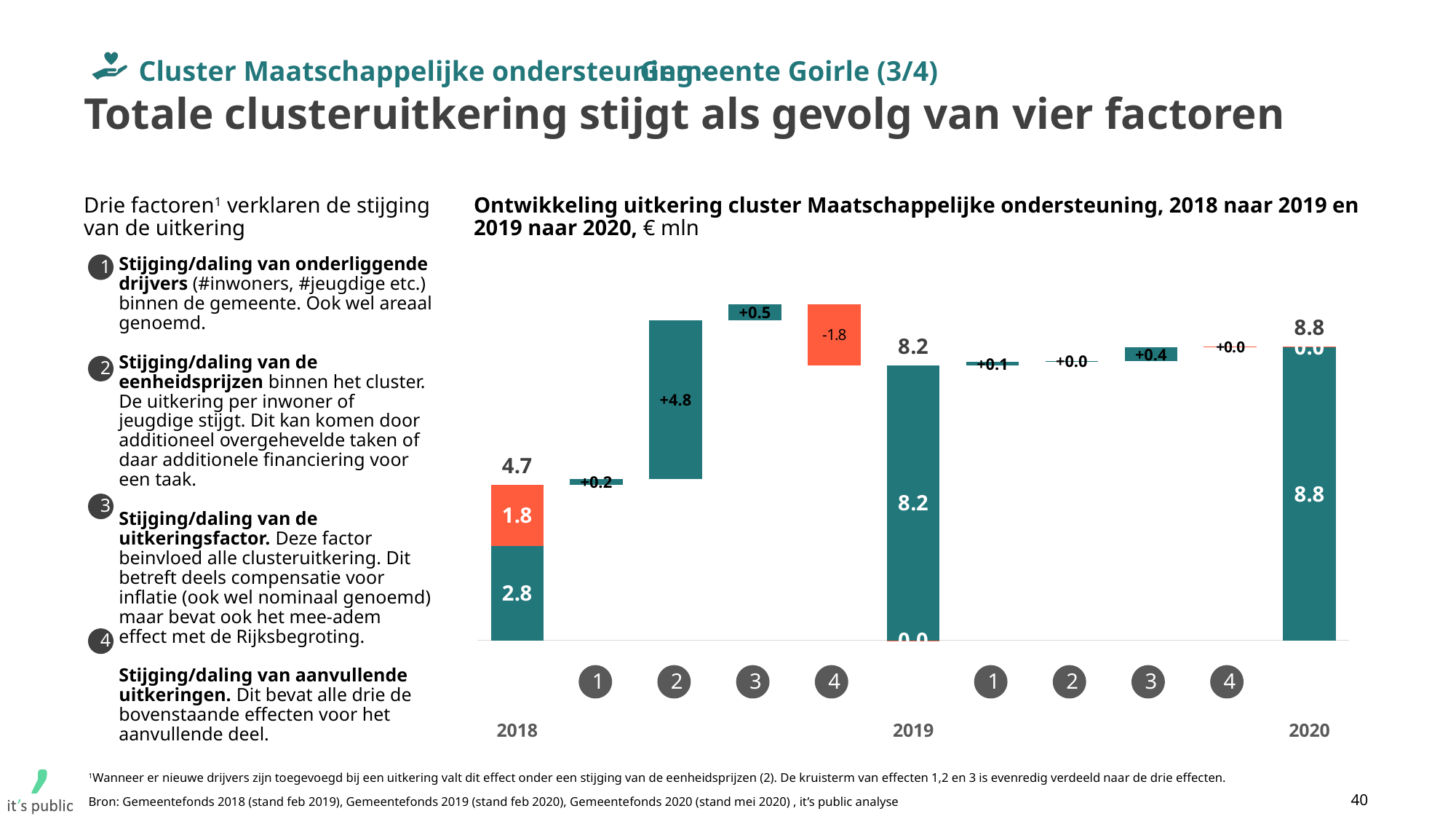
What is the total uitkering shown for 2019? 8.2 What unit is the chart expressed in, according to its title? € mln What is the value of step 4 (aanvullende uitkeringen) between 2018 and 2019? -1.8 By how much does the total uitkering increase from 2018 to 2019? 3.5 What is the total uitkering shown for 2020? 8.8 What is the value of step 2 (eenheidsprijzen) between 2018 and 2019? +4.8 What is the value of the orange segment in the 2018 bar? 1.8 Does the total uitkering rise or fall from 2018 to 2020? Rise What is the total uitkering shown for 2018? 4.7 Which of the four steps between 2018 and 2019 has the largest positive value? Step 2 (+4.8) What is the value of step 3 (uitkeringsfactor) between 2019 and 2020? +0.4 What is the value of the teal segment in the 2018 bar? 2.8